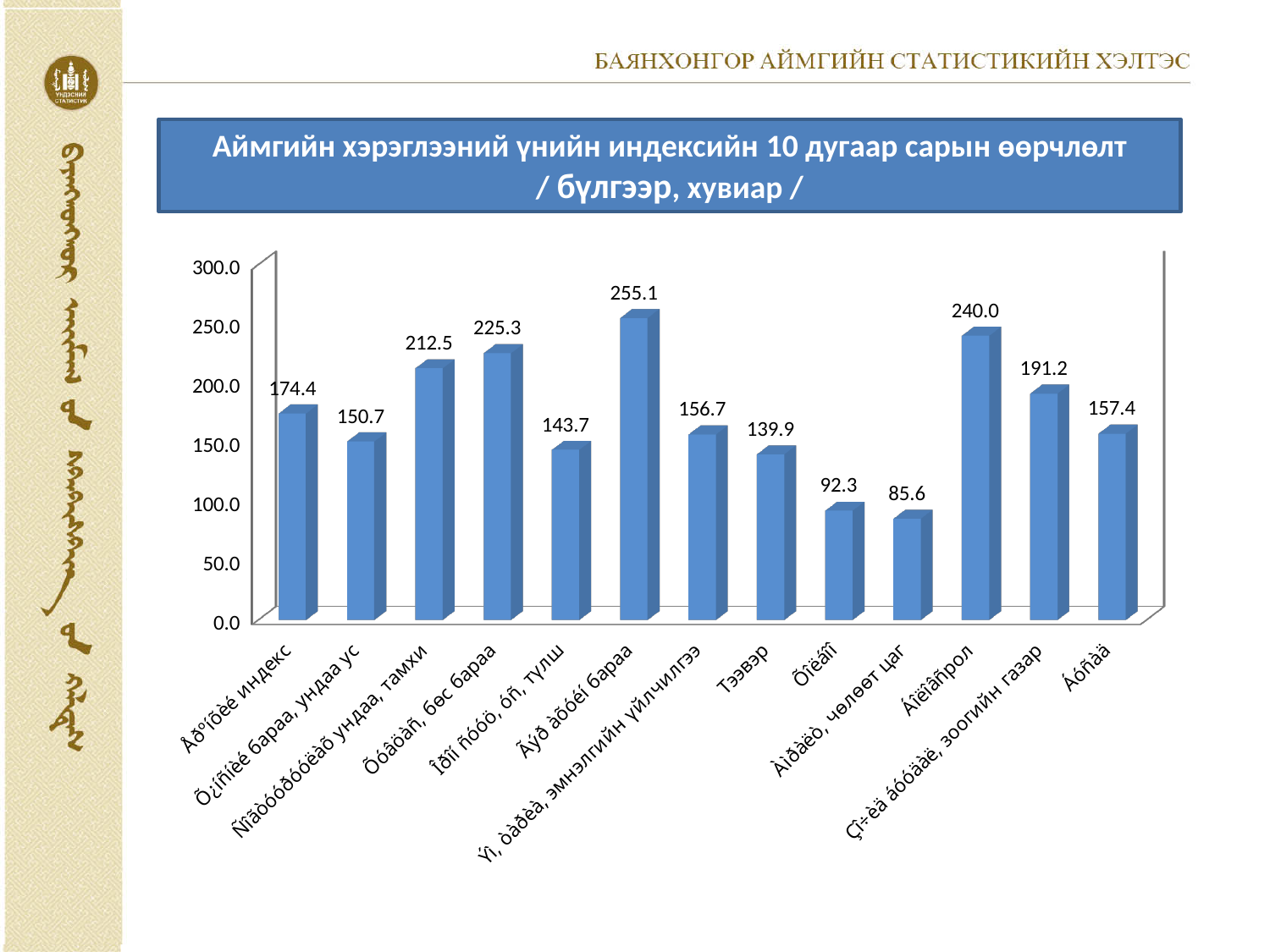
What is the difference between the value of the eleventh bar (240.0) and the value for Тээвэр? 100.1 What is the highest value shown in the chart? 255.1 How many bars (categories) are plotted in the chart? 13 What is the value for Тээвэр? 139.9 Is the value for Тээвэр greater or less than 150.0? less What is the lowest value shown in the chart? 85.6 What is the value of the first bar on the left of the chart? 174.4 What is the difference between the highest value (255.1) and the lowest value (85.6) in the chart? 169.5 What is the title of the chart? Аймгийн хэрэглээний үнийн индексийн 10 дугаар сарын өөрчлөлт / бүлгээр, хувиар / What type of chart is shown on the slide? bar chart Which is larger: the value for Тээвэр or the value of the first bar (174.4)? 174.4 What is the value of the last bar on the right of the chart? 157.4